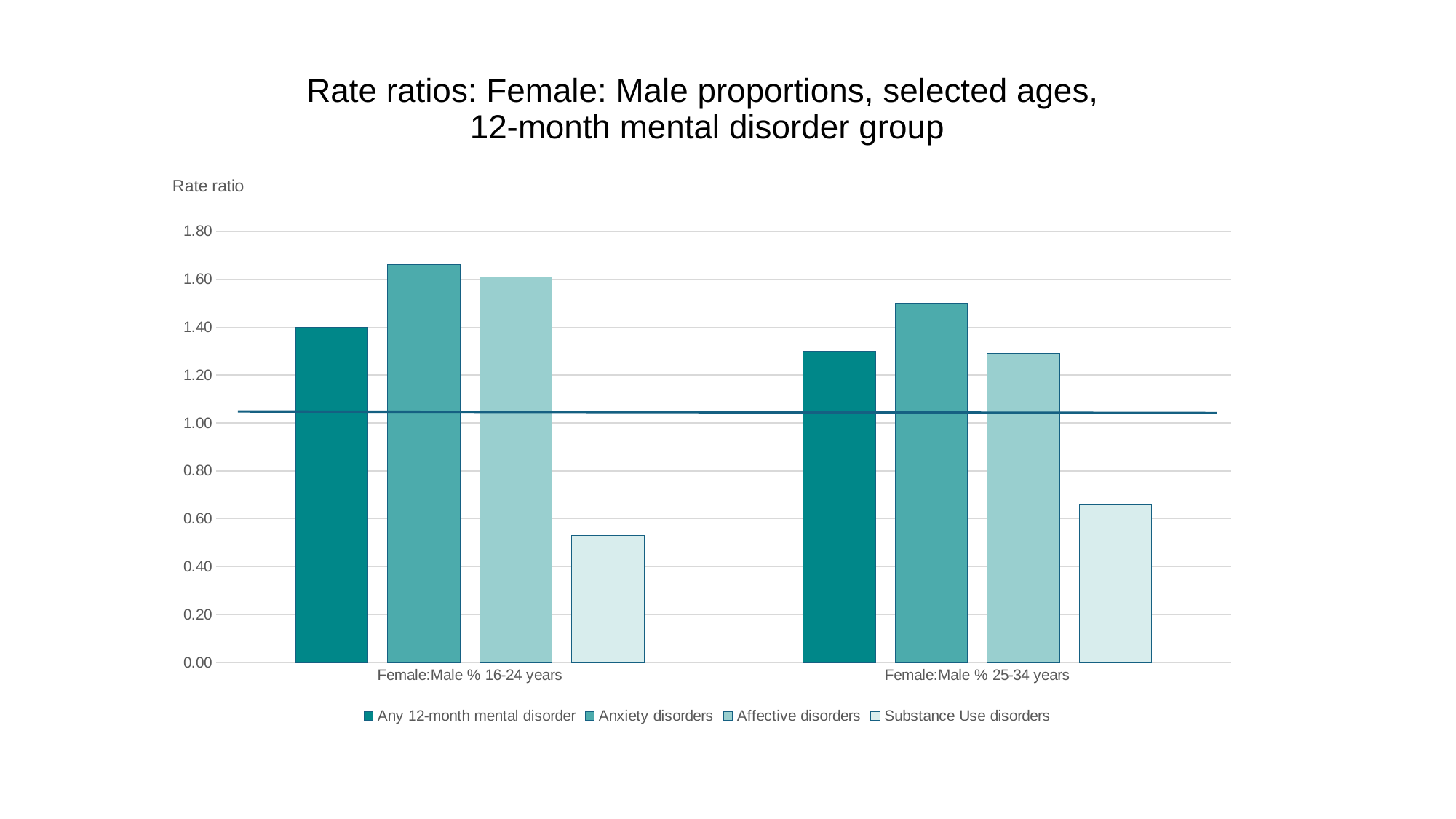
Is the rate ratio for Substance Use disorders in the 16-24 years group greater or less than 0.60? less Which series has the highest rate ratio for Female:Male % 16-24 years? Anxiety disorders Is the rate ratio for Anxiety disorders in the 16-24 years group greater or less than 1.60? greater How many series does the legend list? 4 Which is larger: the Substance Use disorders rate ratio for 16-24 years or for 25-34 years? 25-34 years How many age-group categories are shown on the x axis? 2 Is the rate ratio for Substance Use disorders in the 25-34 years group greater or less than 0.60? greater Which series has the lowest rate ratio for Female:Male % 16-24 years? Substance Use disorders What kind of chart is shown on the slide? bar chart Which series has the lowest rate ratio for Female:Male % 25-34 years? Substance Use disorders What is the label of the vertical axis? Rate ratio Which is larger: the Anxiety disorders rate ratio for 16-24 years or for 25-34 years? 16-24 years